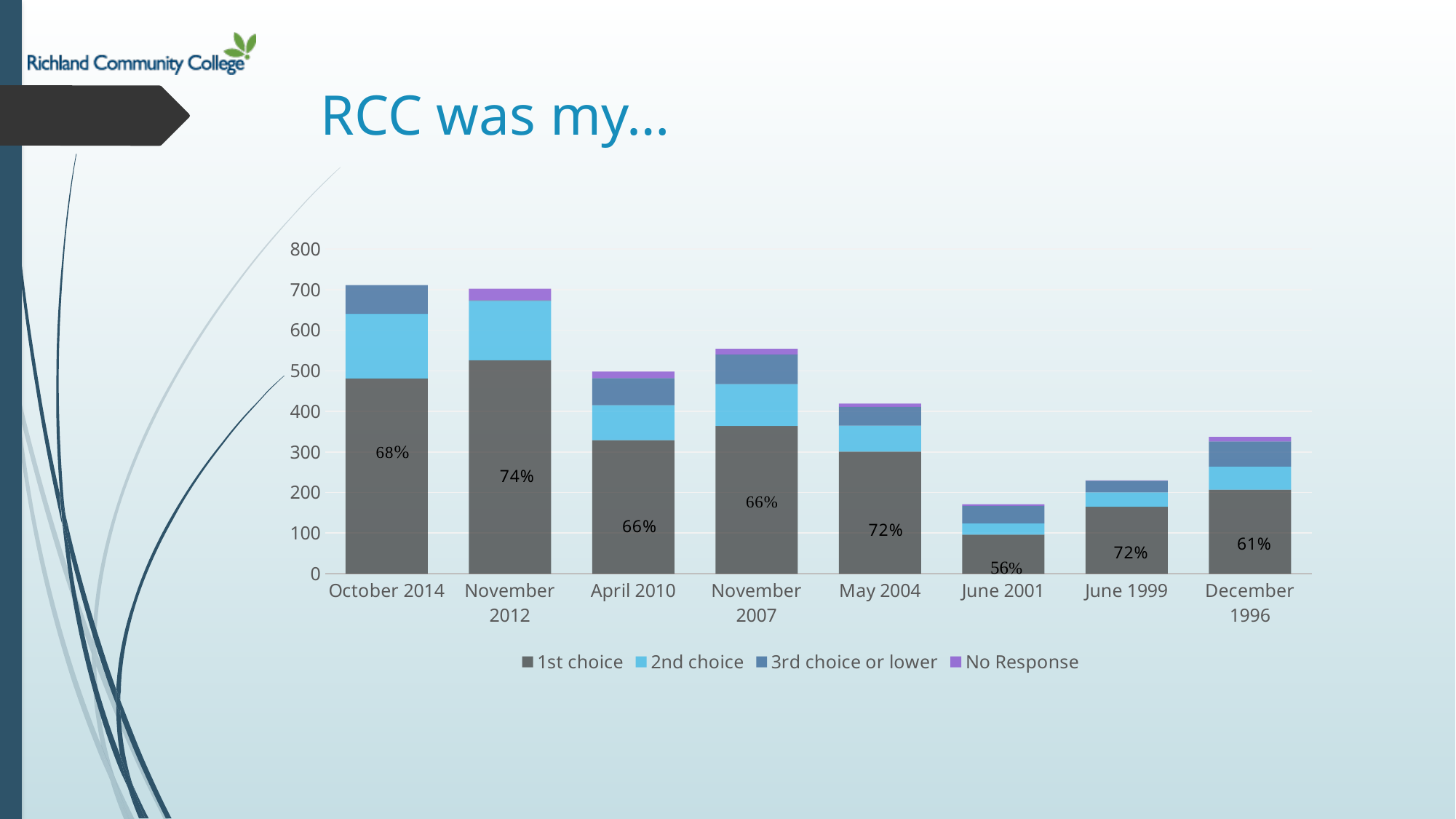
Which has the larger 1st choice percentage label, May 2004 or December 1996? May 2004 What percentage label is shown on the 1st choice segment for November 2012? 74% How many survey periods are shown on the x axis? 8 How many series does the legend list? 4 What is the difference between the 1st choice percentage labels for November 2012 and June 2001? 18 percentage points Is the total height of the stacked bar for October 2014 greater or less than 600? greater What kind of chart is shown on the slide? Stacked bar chart What percentage label is shown on the 1st choice segment for June 2001? 56% Is the total height of the stacked bar for June 2001 greater or less than 200? less Which survey period has the lowest 1st choice percentage label? June 2001 What percentage label is shown on the 1st choice segment for October 2014? 68% Which survey period has the highest 1st choice percentage label? November 2012